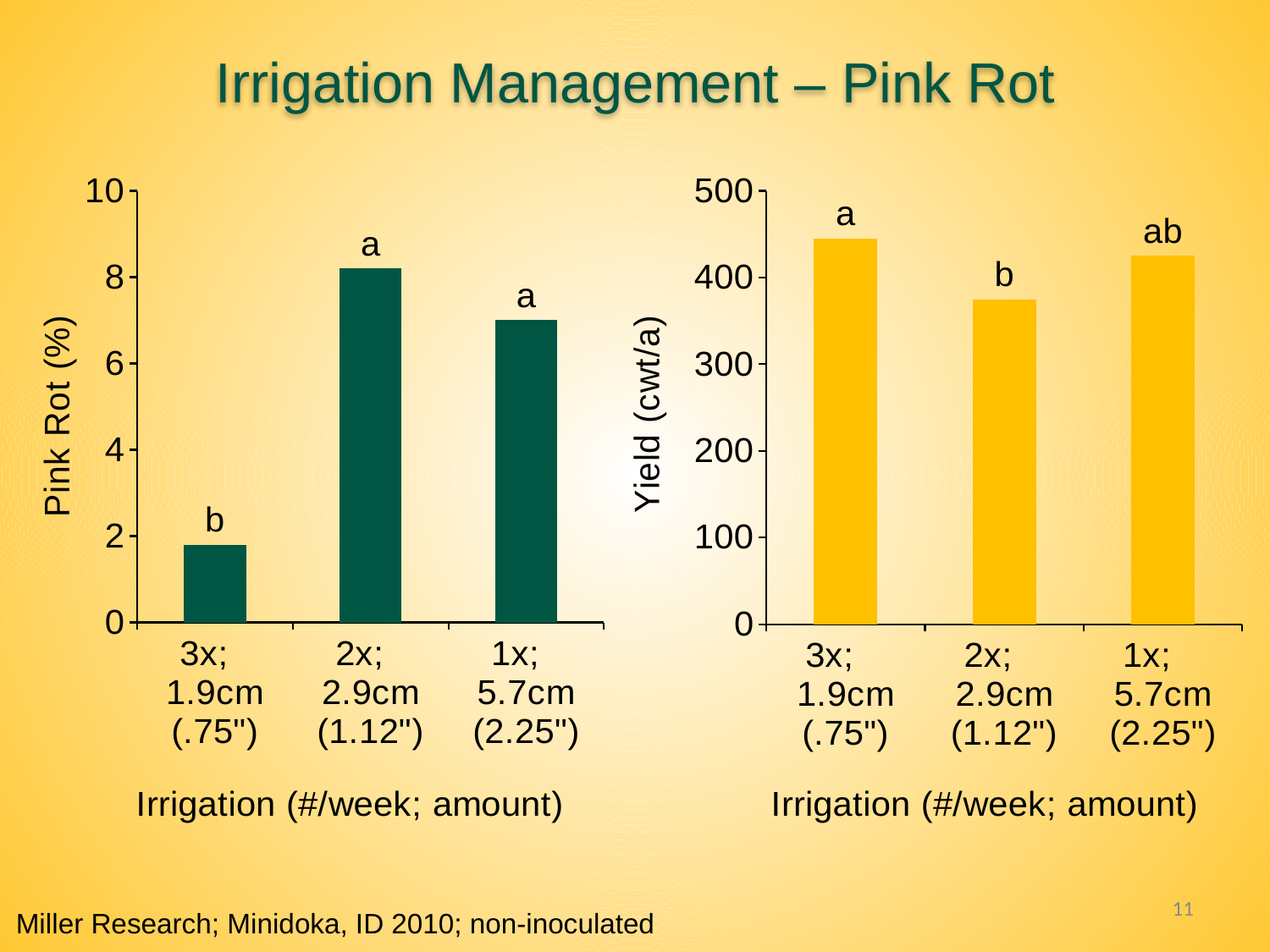
In the right chart (Yield), is the value for 2x; 2.9cm (1.12") greater or less than 400? less In the right chart (Yield), how many bars are shown? 3 In the left chart (Pink Rot), which is larger: the value for 2x; 2.9cm (1.12") or the value for 1x; 5.7cm (2.25")? 2x; 2.9cm (1.12") In the left chart (Pink Rot), how many irrigation treatments are plotted? 3 In the right chart (Yield), which irrigation treatment has the highest yield? 3x; 1.9cm (.75") In the left chart (Pink Rot), which irrigation treatment has the highest pink rot? 2x; 2.9cm (1.12") In the left chart (Pink Rot), which irrigation treatment has the lowest pink rot? 3x; 1.9cm (.75") What kind of chart is the left chart (Pink Rot)? bar chart In the left chart (Pink Rot), is the value for 3x; 1.9cm (.75") greater or less than 2? less What kind of chart is the right chart (Yield)? bar chart In the right chart (Yield), which irrigation treatment has the lowest yield? 2x; 2.9cm (1.12") In the right chart (Yield), what letter label is shown above the bar for 1x; 5.7cm (2.25")? ab